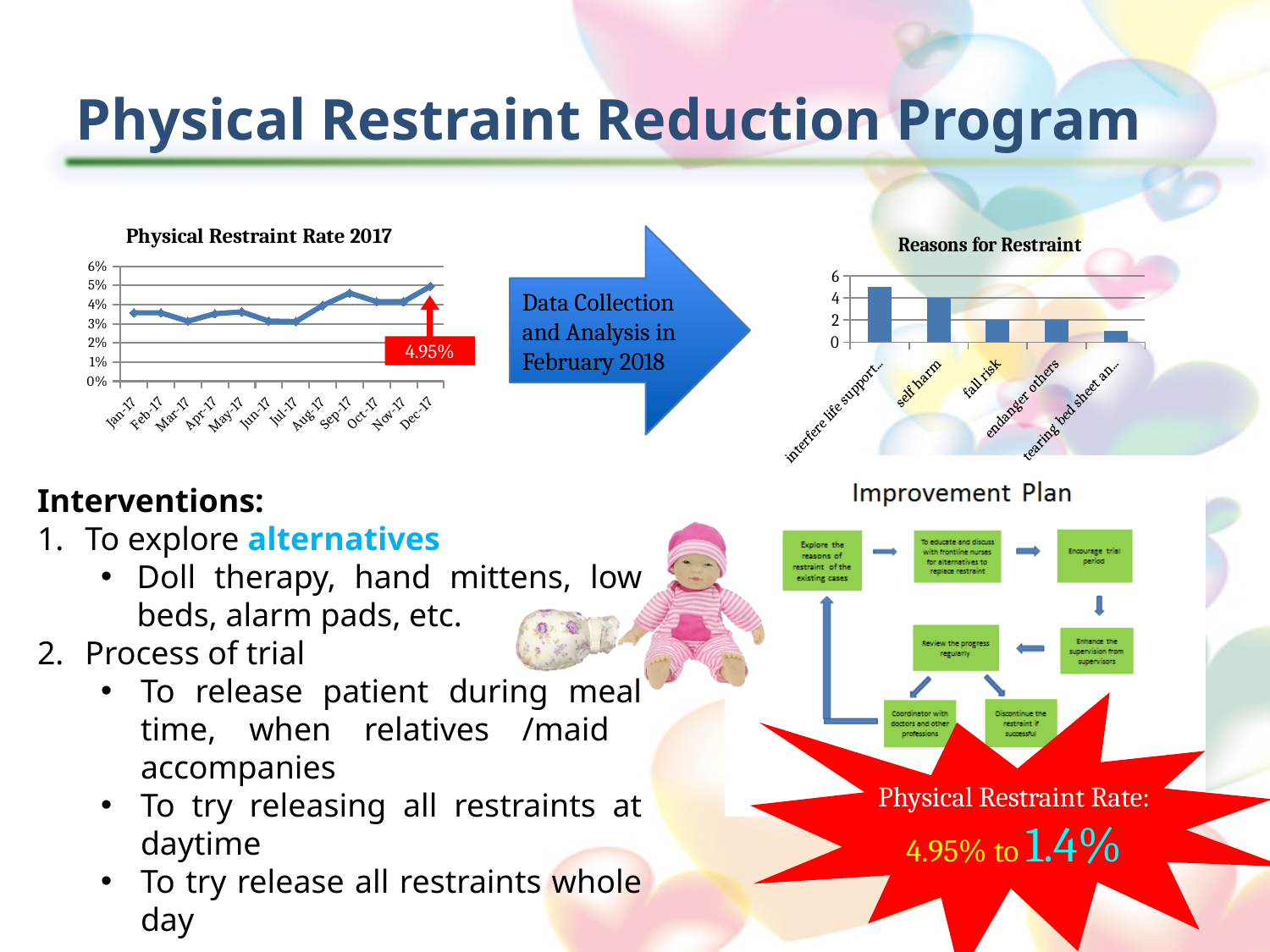
In the 'Reasons for Restraint' chart, what is the difference between the values for self harm and fall risk? 2 In the 'Reasons for Restraint' chart, which reason has the lowest count? tearing bed sheet In the 'Reasons for Restraint' chart, which reason has the highest count? interfere life support In the 'Physical Restraint Rate 2017' chart, what is the value for Dec-17? 4.95% In the 'Physical Restraint Rate 2017' chart, which month has the highest physical restraint rate? Dec-17 In the 'Reasons for Restraint' chart, what is the value for self harm? 4 In the 'Physical Restraint Rate 2017' chart, does the restraint rate overall rise or fall from Jan-17 to Dec-17? rise In the 'Reasons for Restraint' chart, what is the value for fall risk? 2 How many months are plotted in the 'Physical Restraint Rate 2017' chart? 12 What type of chart is the 'Reasons for Restraint' chart? bar chart What type of chart is the 'Physical Restraint Rate 2017' chart? line chart In the 'Physical Restraint Rate 2017' chart, is the value for Sep-17 greater or less than 4%? greater